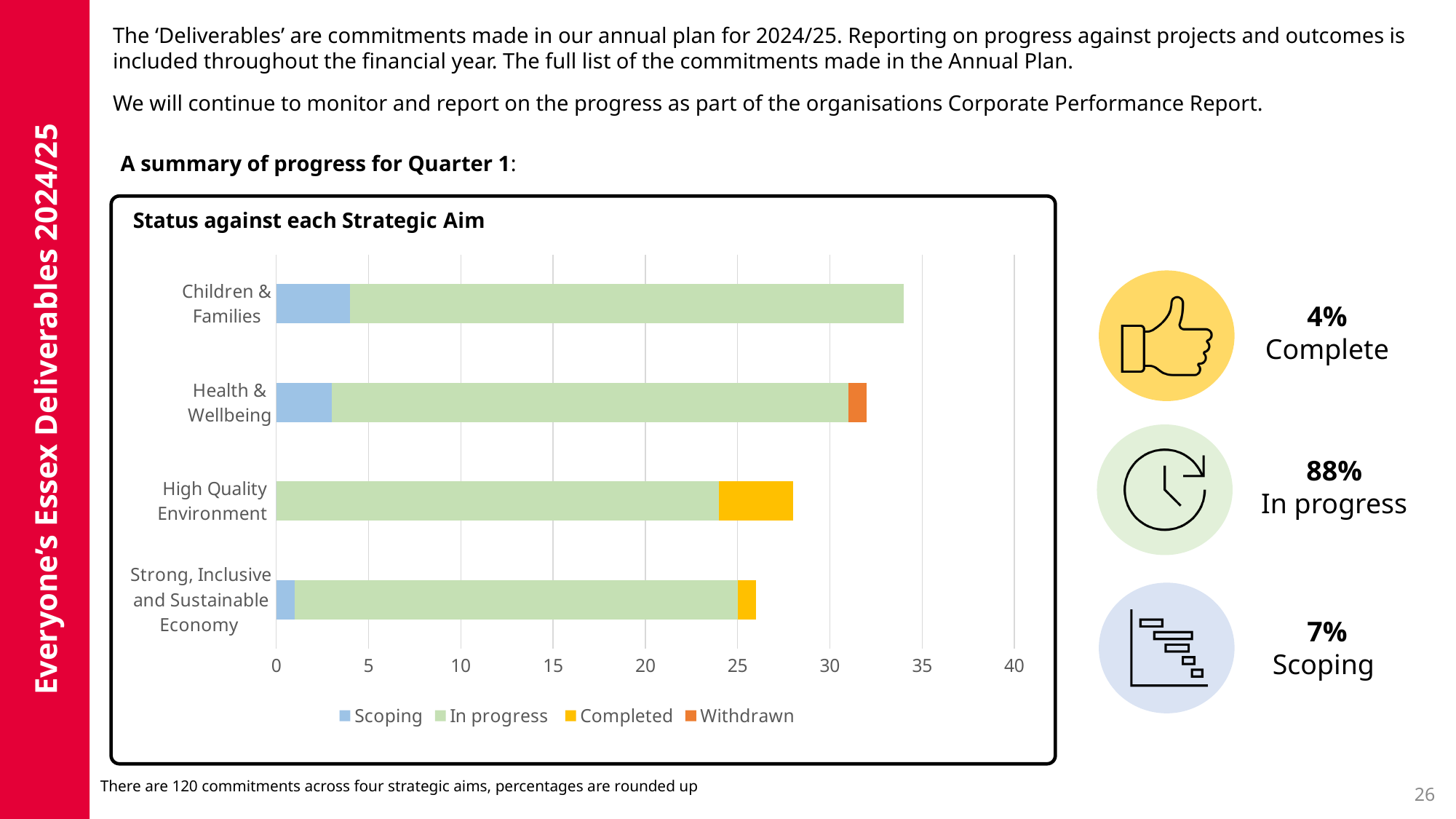
Which strategic aim has the shortest total bar? Strong, Inclusive and Sustainable Economy How many series does the chart legend list? 4 Which has a longer total bar: Health & Wellbeing or Strong, Inclusive and Sustainable Economy? Health & Wellbeing How many strategic aims (categories) are plotted on the chart? 4 What kind of chart is shown on the slide? Stacked bar chart Which strategic aim has the longest total bar? Children & Families Is the total bar length for Strong, Inclusive and Sustainable Economy greater or less than 30? less Is the total bar length for Children & Families greater or less than 30? greater Which has a longer total bar: Children & Families or High Quality Environment? Children & Families Which strategic aim is the only one with a Withdrawn segment? Health & Wellbeing What is the title of the chart? Status against each Strategic Aim Is the total bar length for High Quality Environment greater or less than 25? greater